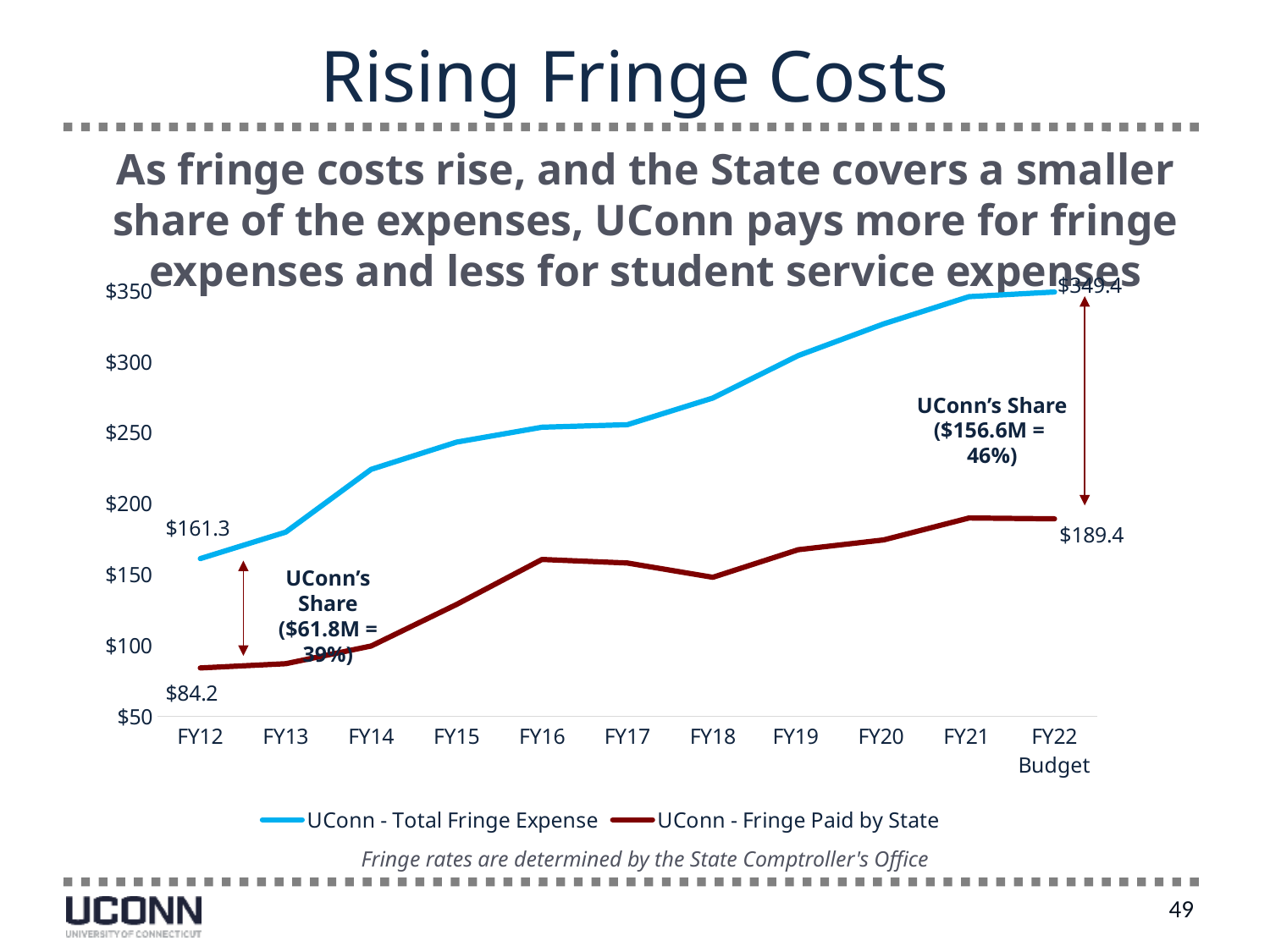
How many fiscal years are plotted along the x axis? 11 Does UConn - Total Fringe Expense generally rise or fall from FY12 to FY22 Budget? rise In which fiscal year is UConn - Fringe Paid by State lowest? FY12 In which fiscal year is UConn - Total Fringe Expense highest? FY22 Budget How many series does the legend list? 2 What is the value of UConn - Fringe Paid by State in FY22 Budget? $189.4 What is the value of UConn - Total Fringe Expense in FY12? $161.3 What is the value of UConn - Total Fringe Expense in FY22 Budget? $349.4 What type of chart is shown on the slide? line chart What is the value of UConn - Fringe Paid by State in FY12? $84.2 Is the value for UConn - Fringe Paid by State in FY16 greater or less than $150? greater Is the value for UConn - Total Fringe Expense in FY14 greater or less than $200? greater